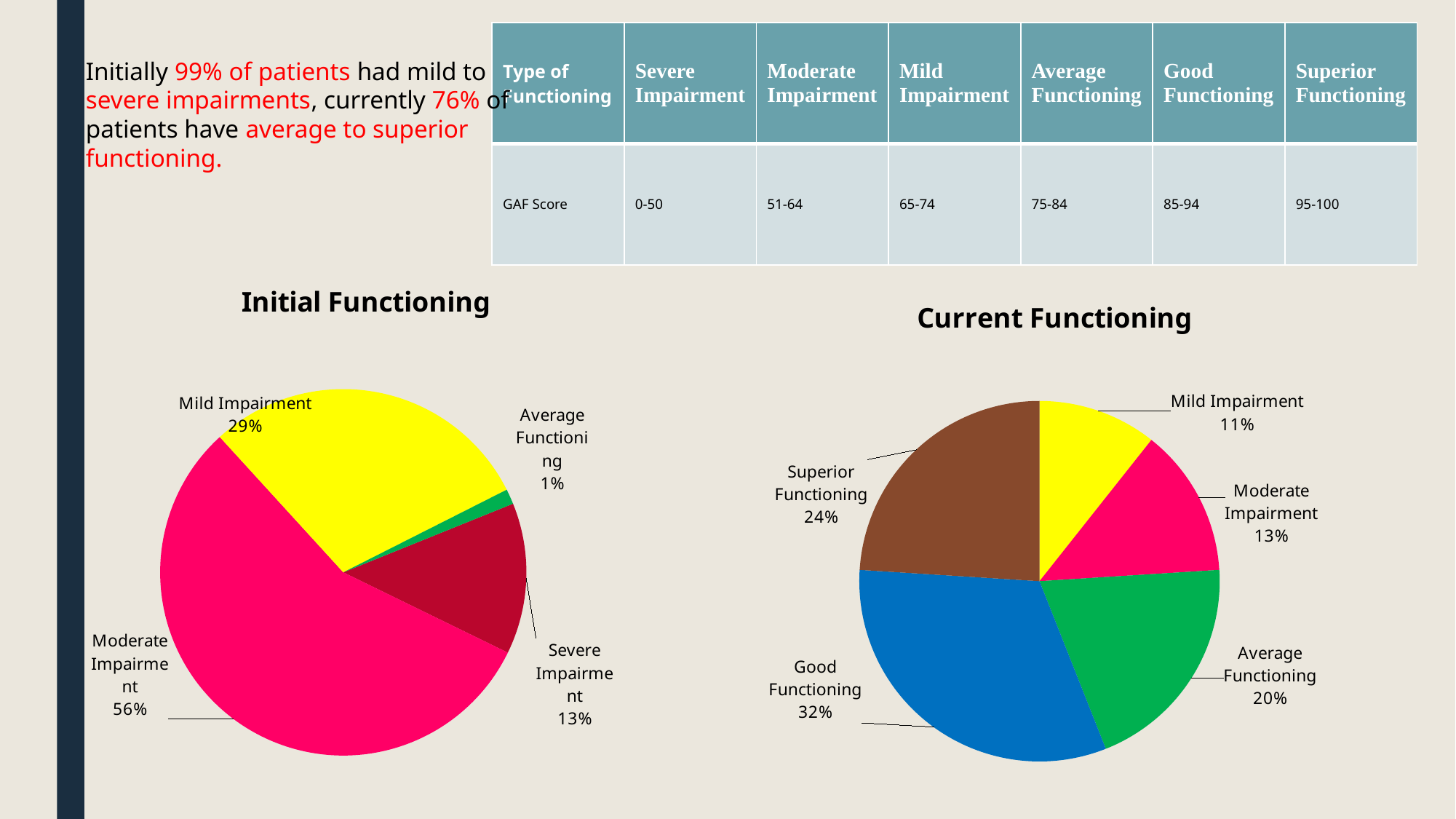
In the Current Functioning chart, which category has the smallest slice? Mild Impairment How many slices does the Current Functioning pie chart have? 5 In the Current Functioning chart, what share of patients have Superior Functioning? 24% In the Initial Functioning chart, which is larger: Mild Impairment or Severe Impairment? Mild Impairment In the Current Functioning chart, what share of patients have Good Functioning? 32% In the Initial Functioning chart, what share of patients had Moderate Impairment? 56% In the Current Functioning chart, which category has the largest slice? Good Functioning In the Initial Functioning chart, which category has the largest slice? Moderate Impairment What type of chart is the Initial Functioning chart? Pie chart In the Initial Functioning chart, what share of patients had Severe Impairment? 13% In the Initial Functioning chart, which category has the smallest slice? Average Functioning In the Current Functioning chart, what is the difference between the Good Functioning and Average Functioning shares? 12%